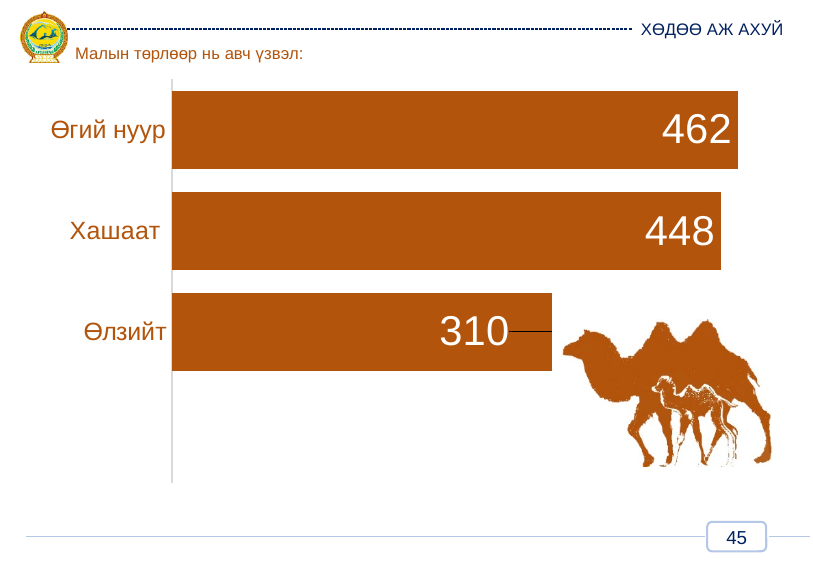
What animal is pictured next to the chart? a camel What is the value for Өгий нуур? 462 What is the value for Хашаат? 448 What kind of chart is shown on the slide? bar chart What is the difference between the values for Өгий нуур and Өлзийт? 152 What is the difference between the values for Өгий нуур and Хашаат? 14 Which category has the highest value? Өгий нуур How many categories are shown in the chart? 3 Which category has the lowest value? Өлзийт What is the value for Өлзийт? 310 Which is larger, the value for Хашаат or the value for Өлзийт? Хашаат What colour are the bars in the chart? orange-brown